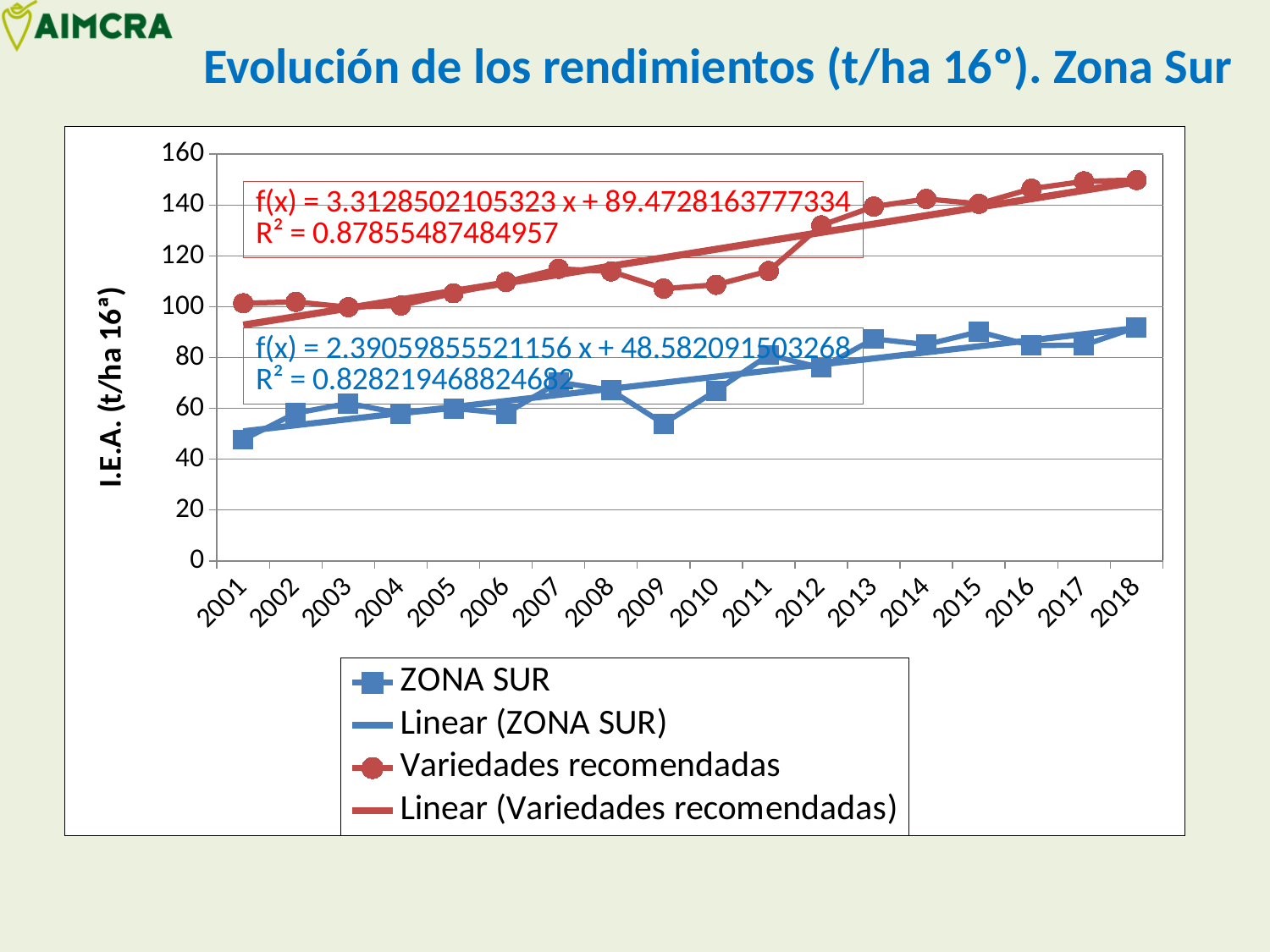
Is the value for ZONA SUR in 2009 greater or less than 60? less For Variedades recomendadas, which year has the larger value, 2011 or 2012? 2012 Is the value for Variedades recomendadas in 2018 greater or less than 140? greater Is the value for Variedades recomendadas in 2009 greater or less than 100? greater How many entries does the legend list? 4 What kind of chart is shown on the slide? line chart What is the title of the chart? Evolución de los rendimientos (t/ha 16°). Zona Sur In 2009, which series has the larger value, ZONA SUR or Variedades recomendadas? Variedades recomendadas What R² value is shown for the Variedades recomendadas trendline? 0.87855487484957 How many years are plotted along the x axis? 18 Do the values for Variedades recomendadas generally rise or fall from 2001 to 2018? rise